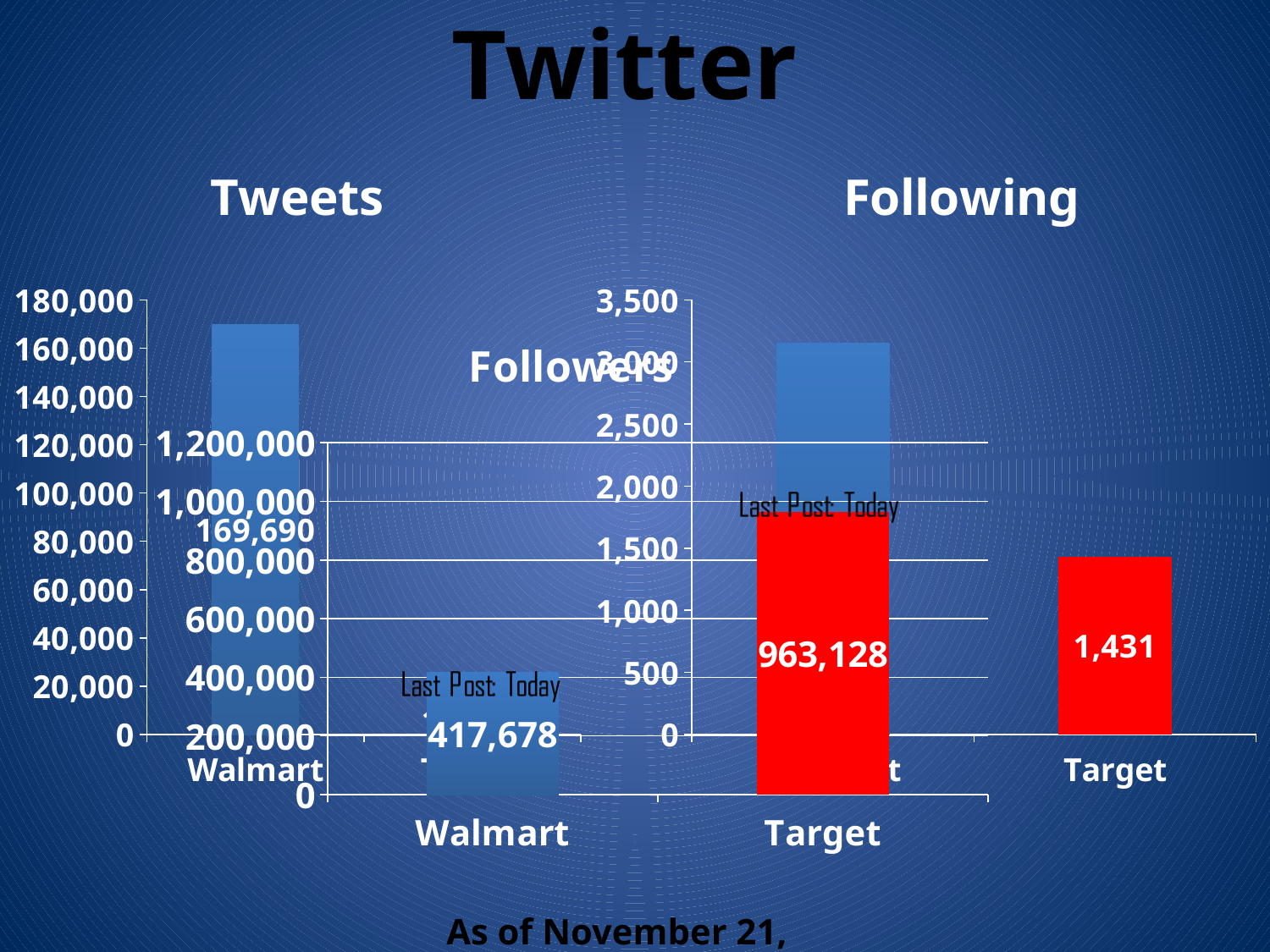
In the Followers chart, is the value for Target greater or less than 1,000,000? less In the Followers chart, what is the difference between Target's and Walmart's values? 545,450 What kind of chart is the Followers chart? bar chart In the Followers chart, what is the value for Walmart? 417,678 In the Tweets chart, what is the value for Walmart? 169,690 In the Followers chart, which category has the highest value? Target In the Following chart, what is the value for Target? 1,431 In the Following chart, is the value for Walmart greater or less than 2,500? greater In the Tweets chart, is the value for Walmart greater or less than 160,000? greater How many categories are shown in the Followers chart? 2 In the Followers chart, what is the value for Target? 963,128 In the Following chart, which is larger, the value for Walmart or the value for Target? Walmart